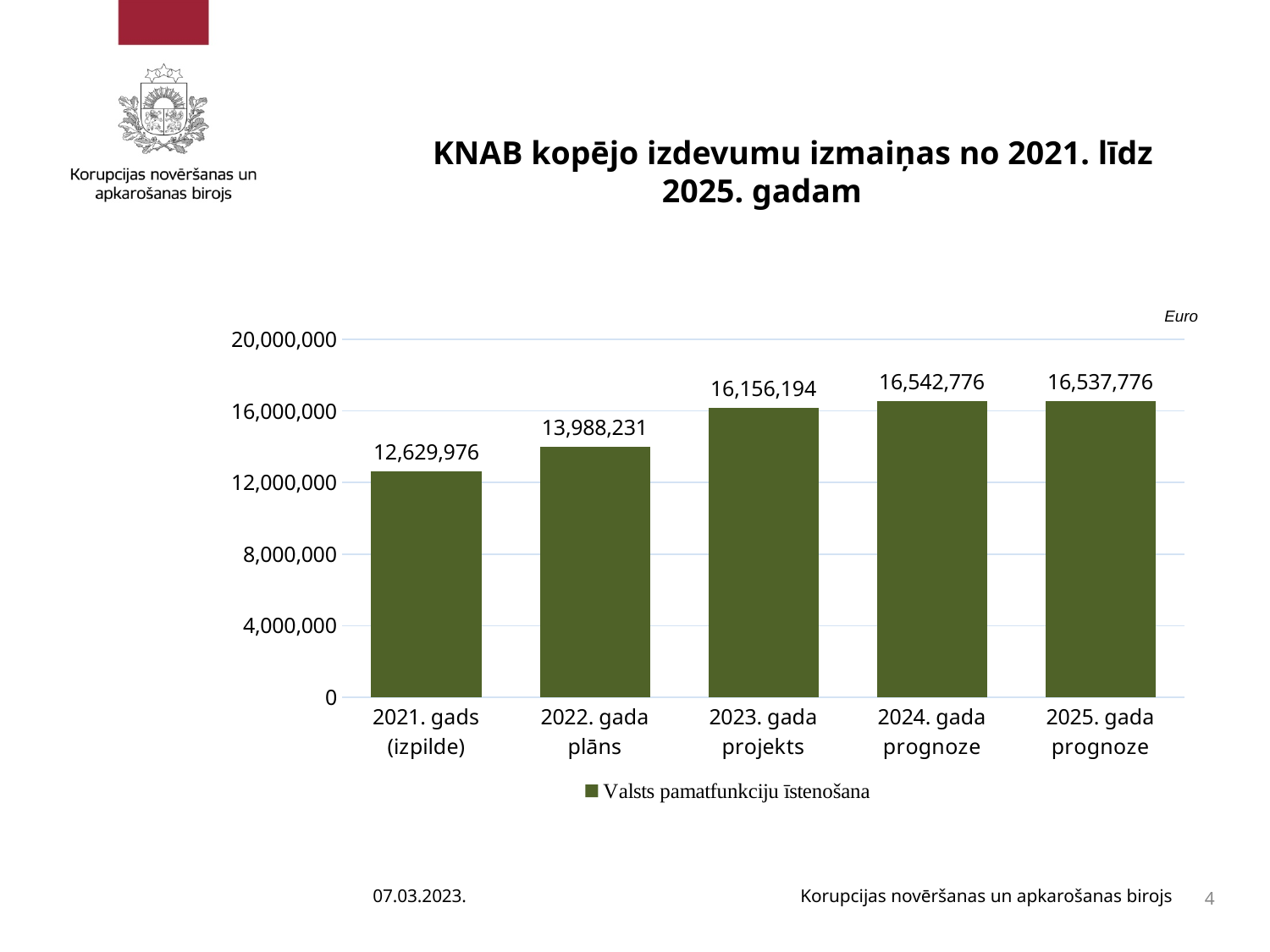
How many categories are shown on the x axis? 5 What is the value for 2023. gada projekts? 16,156,194 What is the difference between the values for 2024. gada prognoze and 2025. gada prognoze? 5,000 Which category has the lowest value? 2021. gads (izpilde) What is the difference between the values for 2022. gada plāns and 2021. gads (izpilde)? 1,358,255 What is the value for 2021. gads (izpilde)? 12,629,976 What is the legend entry of the series shown in the chart? Valsts pamatfunkciju īstenošana Which is larger, the value for 2022. gada plāns or the value for 2023. gada projekts? 2023. gada projekts What is the value for 2025. gada prognoze? 16,537,776 Is the value for 2021. gads (izpilde) greater or less than 16,000,000? less What kind of chart is shown on the slide? bar chart Which category has the highest value? 2024. gada prognoze